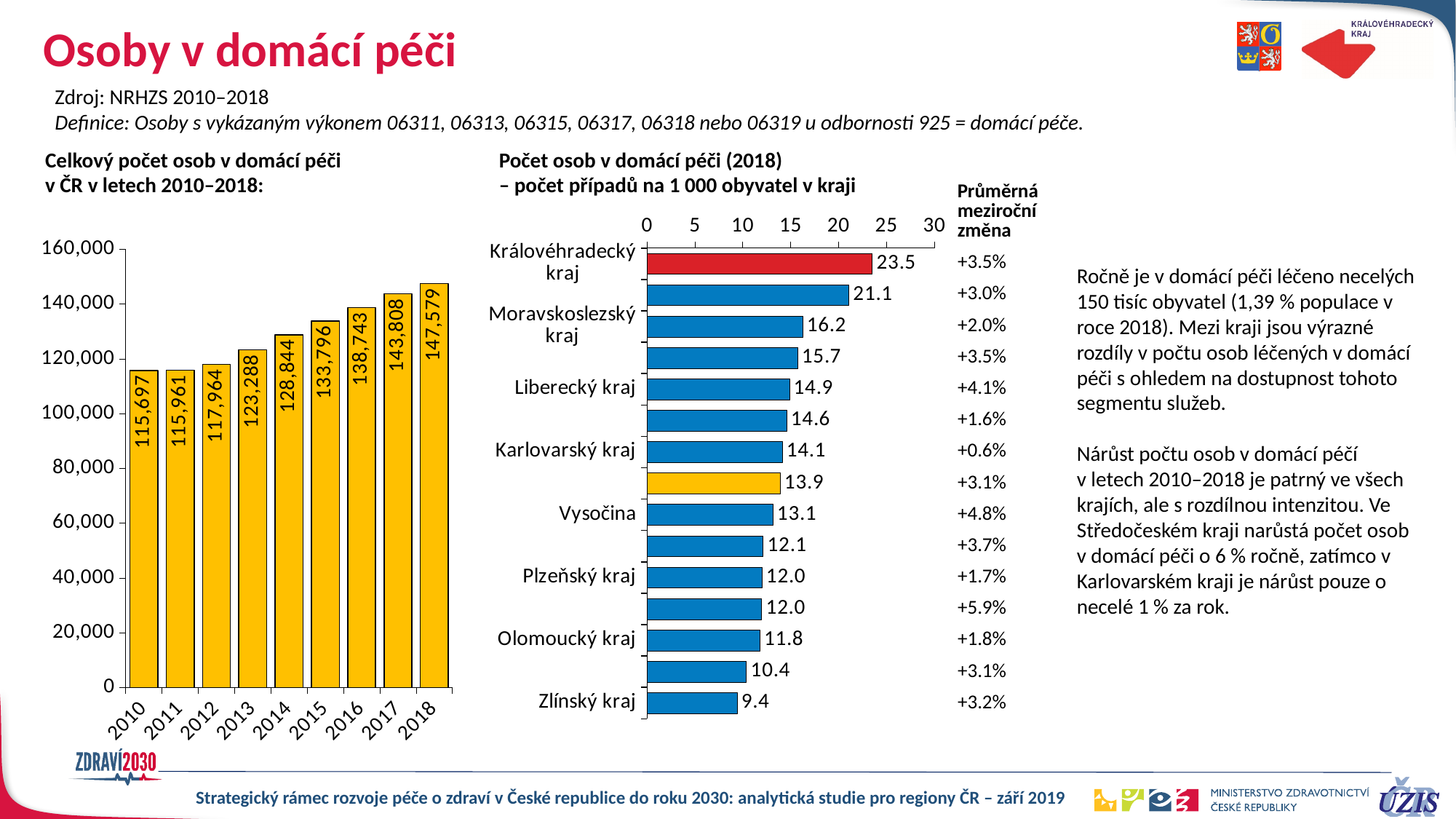
In the right chart (Počet osob v domácí péči (2018) – počet případů na 1 000 obyvatel v kraji), what is the value for Královéhradecký kraj? 23.5 In the right chart (Počet osob v domácí péči (2018) – počet případů na 1 000 obyvatel v kraji), what is the value for Zlínský kraj? 9.4 In the right chart (Počet osob v domácí péči (2018) – počet případů na 1 000 obyvatel v kraji), which is larger, the value for Liberecký kraj or Karlovarský kraj? Liberecký kraj In the left chart (Celkový počet osob v domácí péči v ČR v letech 2010–2018), what is the value for 2010? 115,697 In the left chart (Celkový počet osob v domácí péči v ČR v letech 2010–2018), do the values rise or fall from 2010 to 2018? rise In the right chart (Počet osob v domácí péči (2018) – počet případů na 1 000 obyvatel v kraji), which region has the lowest value? Zlínský kraj In the left chart (Celkový počet osob v domácí péči v ČR v letech 2010–2018), which year has the highest value? 2018 In the left chart (Celkový počet osob v domácí péči v ČR v letech 2010–2018), how many years are plotted? 9 In the left chart (Celkový počet osob v domácí péči v ČR v letech 2010–2018), what is the value for 2018? 147,579 What kind of chart is the left chart (Celkový počet osob v domácí péči v ČR v letech 2010–2018)? bar chart In the right chart (Počet osob v domácí péči (2018) – počet případů na 1 000 obyvatel v kraji), what is the difference between the values for Moravskoslezský kraj and Plzeňský kraj? 4.2 In the left chart (Celkový počet osob v domácí péči v ČR v letech 2010–2018), what is the difference between the values for 2018 and 2017? 3,771